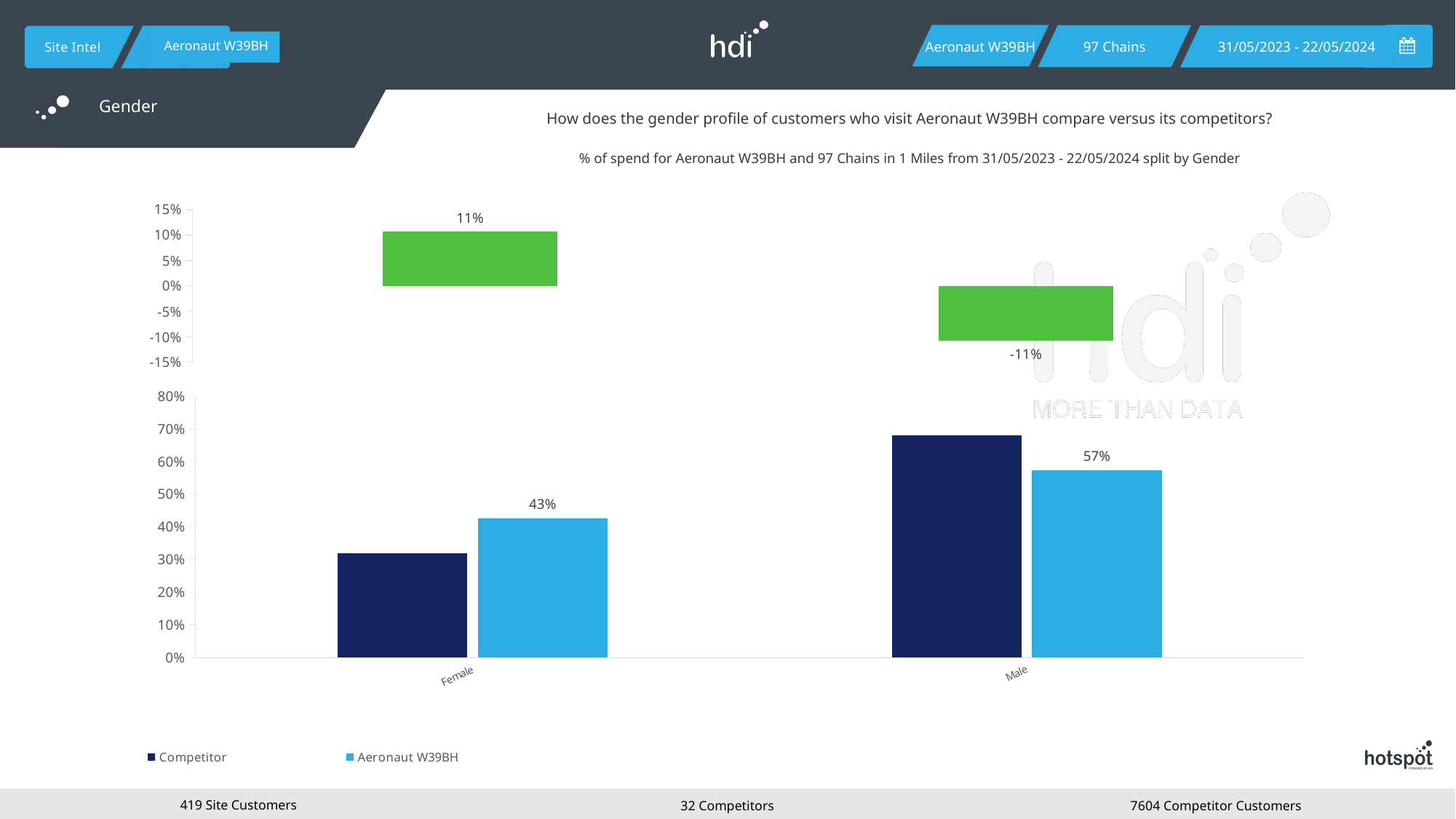
In the bottom chart, for Male, which is larger: the Competitor bar or the Aeronaut W39BH bar? Competitor In the bottom chart, what is the value for Aeronaut W39BH for Female? 43% In the top chart, what is the value shown for Male? -11% How many series does the legend of the bottom chart list? 2 In the bottom chart, is the Competitor value for Male greater or less than 60%? greater In the bottom chart, is the Competitor value for Female greater or less than 40%? less In the top chart, what is the value shown for Female? 11% What type of chart is the bottom chart? Bar chart In the bottom chart, for Female, which is larger: the Competitor bar or the Aeronaut W39BH bar? Aeronaut W39BH In the bottom chart, which gender has the higher Aeronaut W39BH value? Male In the bottom chart, what is the value for Aeronaut W39BH for Male? 57% In the bottom chart, what is the difference between the Aeronaut W39BH values for Male and Female? 14%